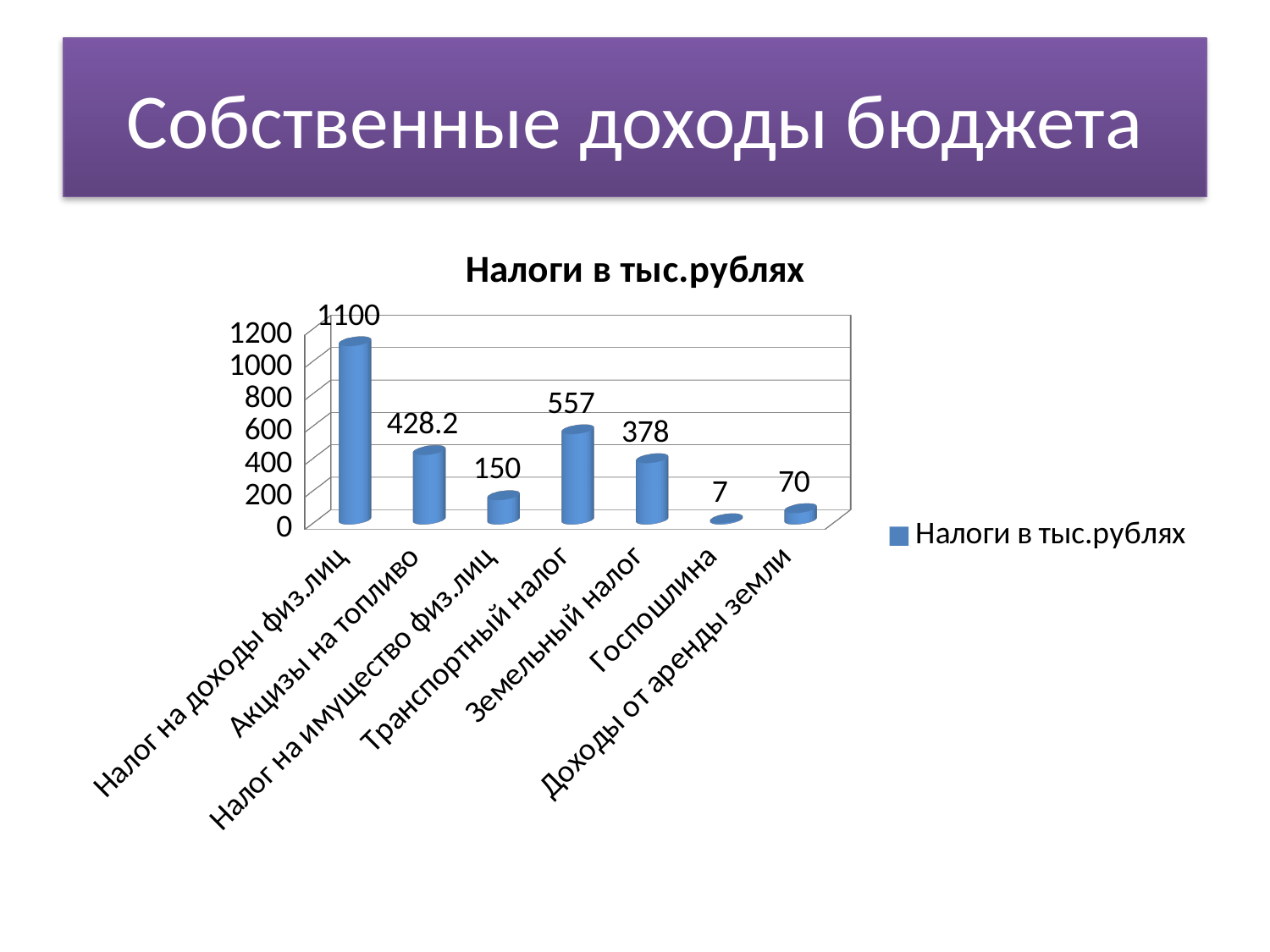
What kind of chart is shown? Bar chart What is the value for Транспортный налог? 557 What is the difference between Транспортный налог and Земельный налог? 179 Which category has the highest value? Налог на доходы физ.лиц What is the value for Госпошлина? 7 Which category has the lowest value? Госпошлина What is the title of the chart? Налоги в тыс.рублях How many categories are shown in the chart? 7 What is the value for Акцизы на топливо? 428.2 Which is larger, Акцизы на топливо or Земельный налог? Акцизы на топливо What is the value for Налог на доходы физ.лиц? 1100 How many series does the legend list? 1